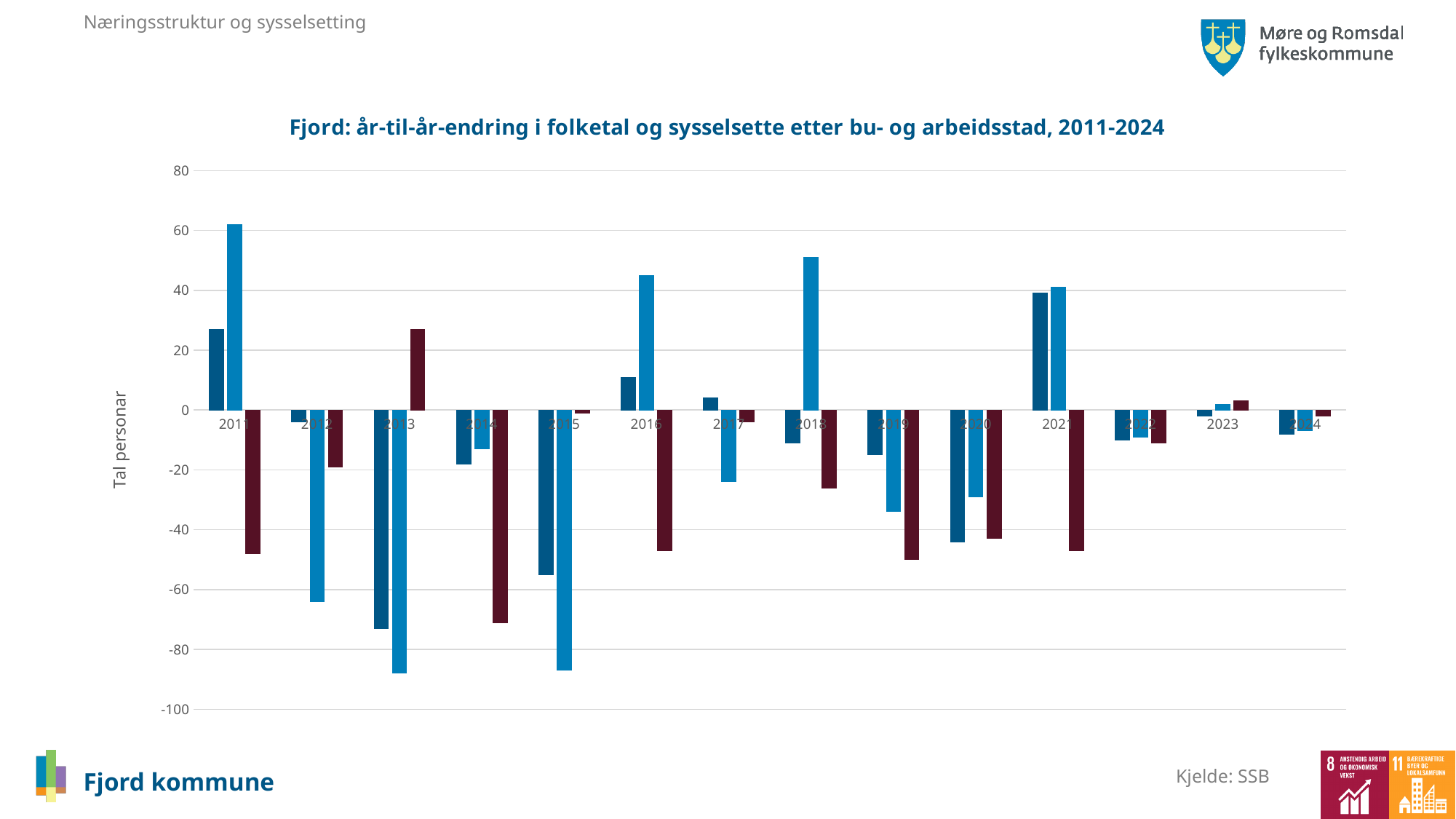
What is the label on the vertical axis of the chart? Tal personar In which year is the light blue bar the highest? 2011 What kind of chart is shown on the slide? bar chart Is the light blue bar for 2011 greater or less than 40? greater What is the title of the chart? Fjord: år-til-år-endring i folketal og sysselsette etter bu- og arbeidsstad, 2011-2024 Is the light blue bar for 2013 greater or less than -80? less In which year is the dark red bar the lowest? 2014 In which year is the dark red bar the highest? 2013 Which is larger, the dark blue bar for 2021 or the dark blue bar for 2011? 2021 How many years are shown along the x axis of the chart? 14 Which is larger, the light blue bar for 2011 or the light blue bar for 2016? 2011 Is the dark blue bar for 2021 greater or less than 20? greater